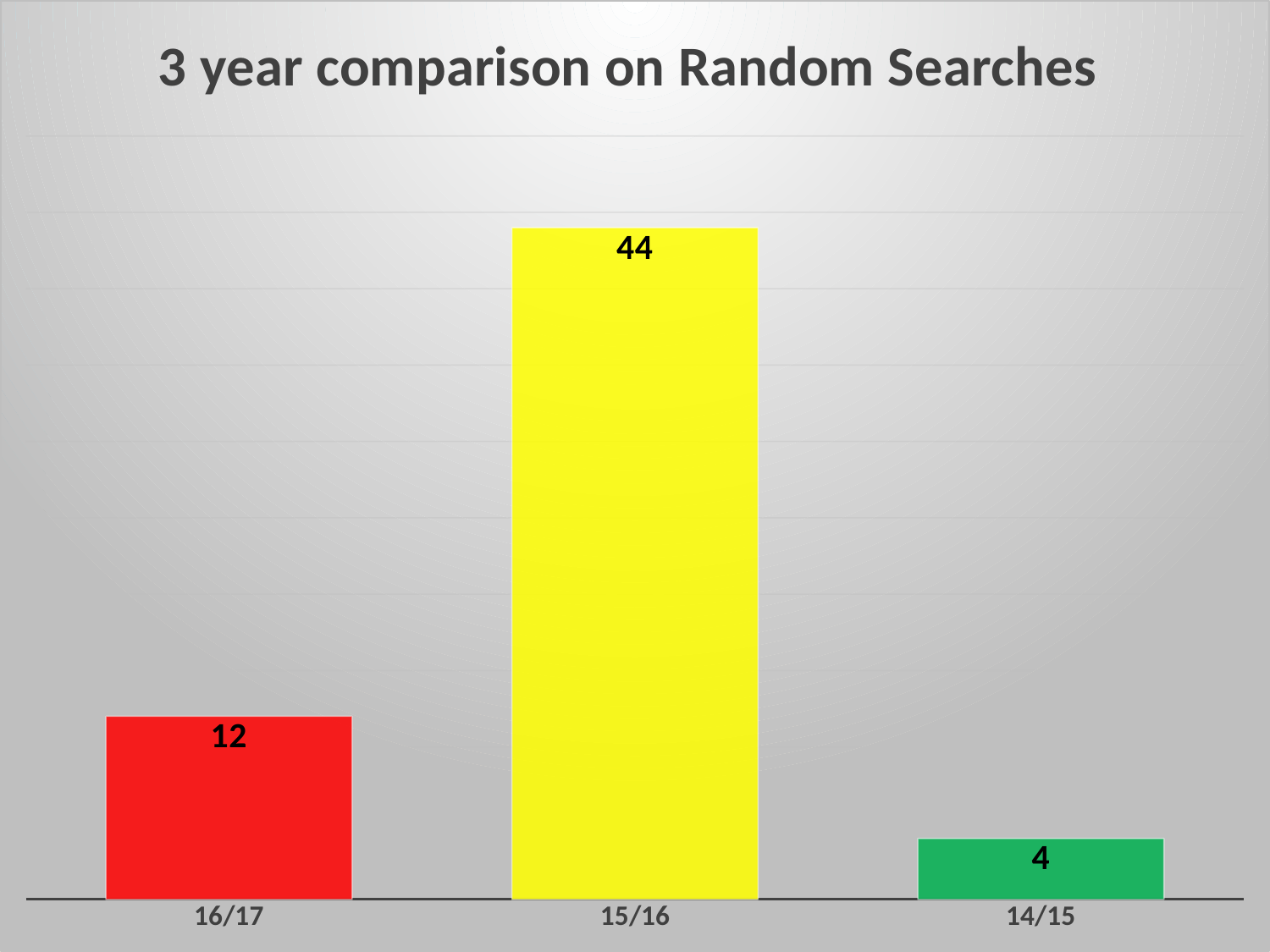
What kind of chart is this? bar chart What is the value for 16/17? 12 What is the value for 15/16? 44 What is the title of the chart? 3 year comparison on Random Searches How many categories are shown on the chart? 3 What is the value for 14/15? 4 What colour is the bar for 15/16? yellow Which year has the lowest value? 14/15 What is the difference between the values for 16/17 and 14/15? 8 Which is larger, the value for 16/17 or the value for 14/15? 16/17 Which year has the highest value? 15/16 What is the difference between the values for 15/16 and 16/17? 32